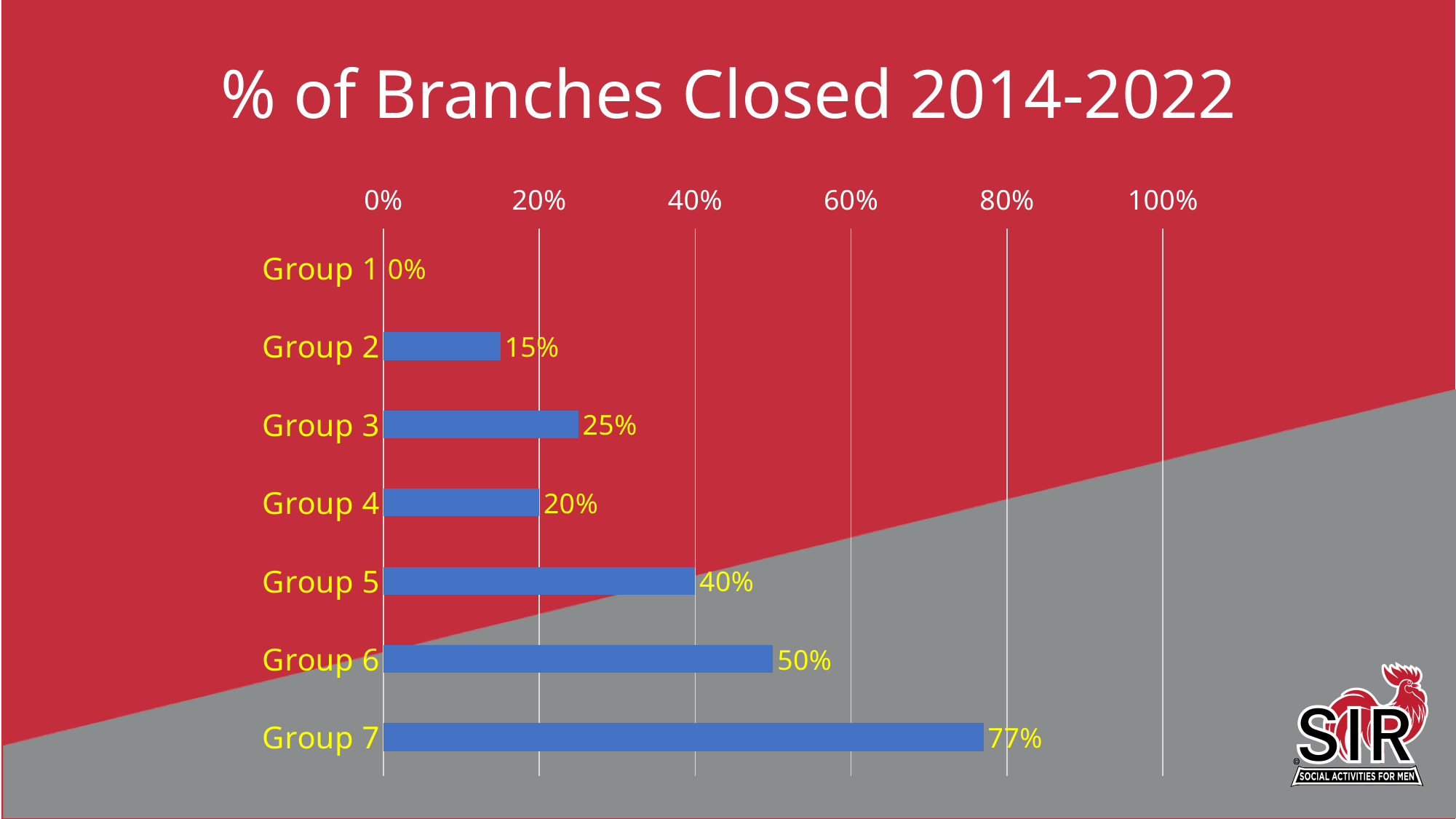
What kind of chart is shown on the slide? Bar chart Which group has the lowest percentage of branches closed? Group 1 What is the value for Group 3? 25% What is the value for Group 7? 77% Which group has the highest percentage of branches closed? Group 7 What is the difference between the values for Group 6 and Group 2? 35% Is the value for Group 6 greater or less than 40%? greater Which is larger, the value for Group 3 or the value for Group 4? Group 3 What is the title of the chart? % of Branches Closed 2014-2022 What is the value for Group 5? 40% How many groups are shown in the chart? 7 What is the difference between the values for Group 7 and Group 5? 37%